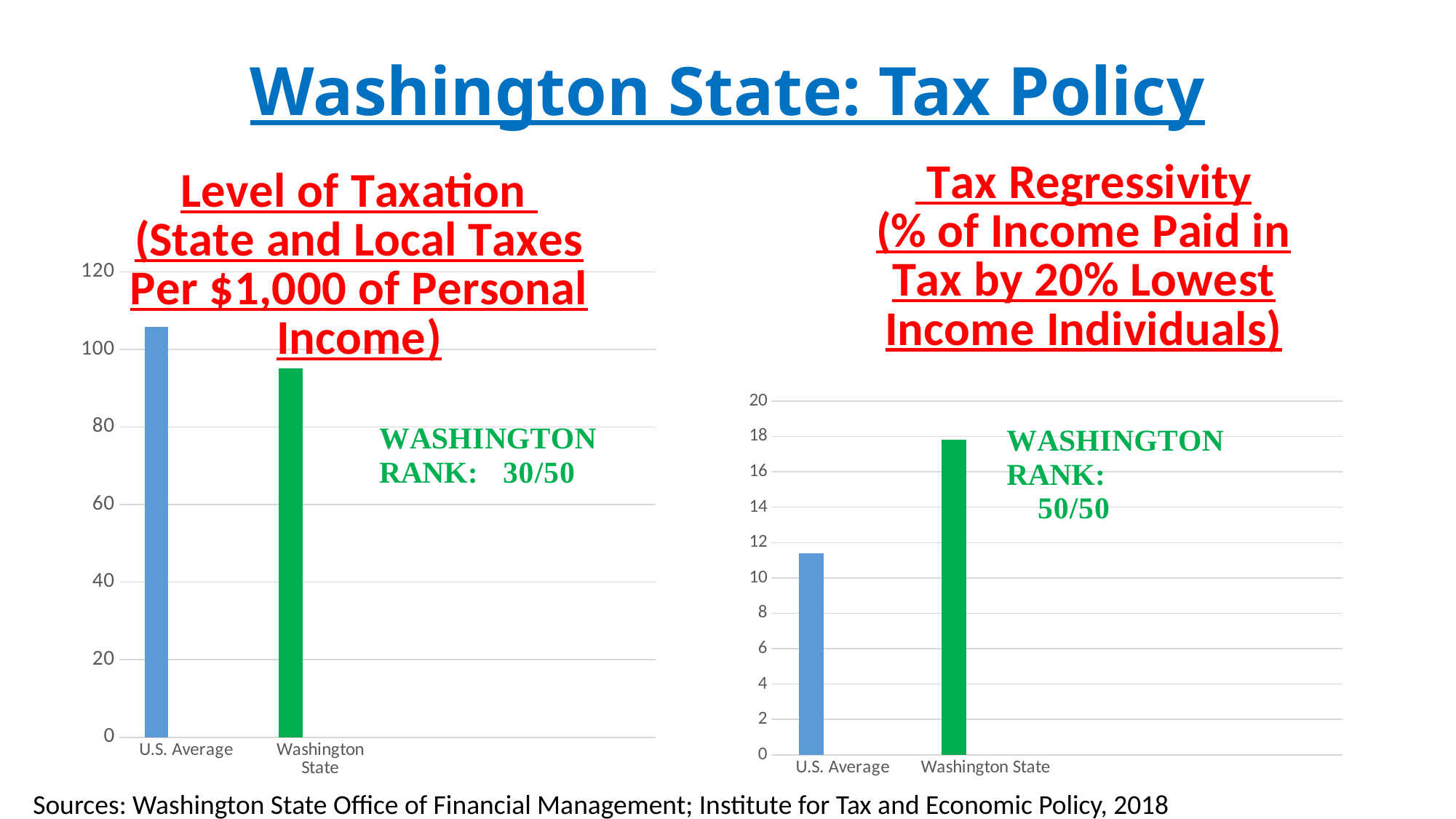
What Washington rank is shown next to the Tax Regressivity chart on the right? 50/50 In the Level of Taxation chart on the left, is the value for Washington State greater or less than 100? less In the Level of Taxation chart on the left, how many categories are plotted? 2 In the Tax Regressivity chart on the right, is the value for U.S. Average greater or less than 12? less What Washington rank is shown next to the Level of Taxation chart on the left? 30/50 In the Tax Regressivity chart on the right, is the bar for Washington State larger or smaller than the bar for U.S. Average? larger What kind of chart is the Tax Regressivity chart on the right? bar chart In the Tax Regressivity chart on the right, is the value for Washington State greater or less than 16? greater In the Tax Regressivity chart on the right, which category has the higher bar? Washington State In the Level of Taxation chart on the left, which category has the higher bar? U.S. Average In the Level of Taxation chart on the left, which category has the lower bar? Washington State